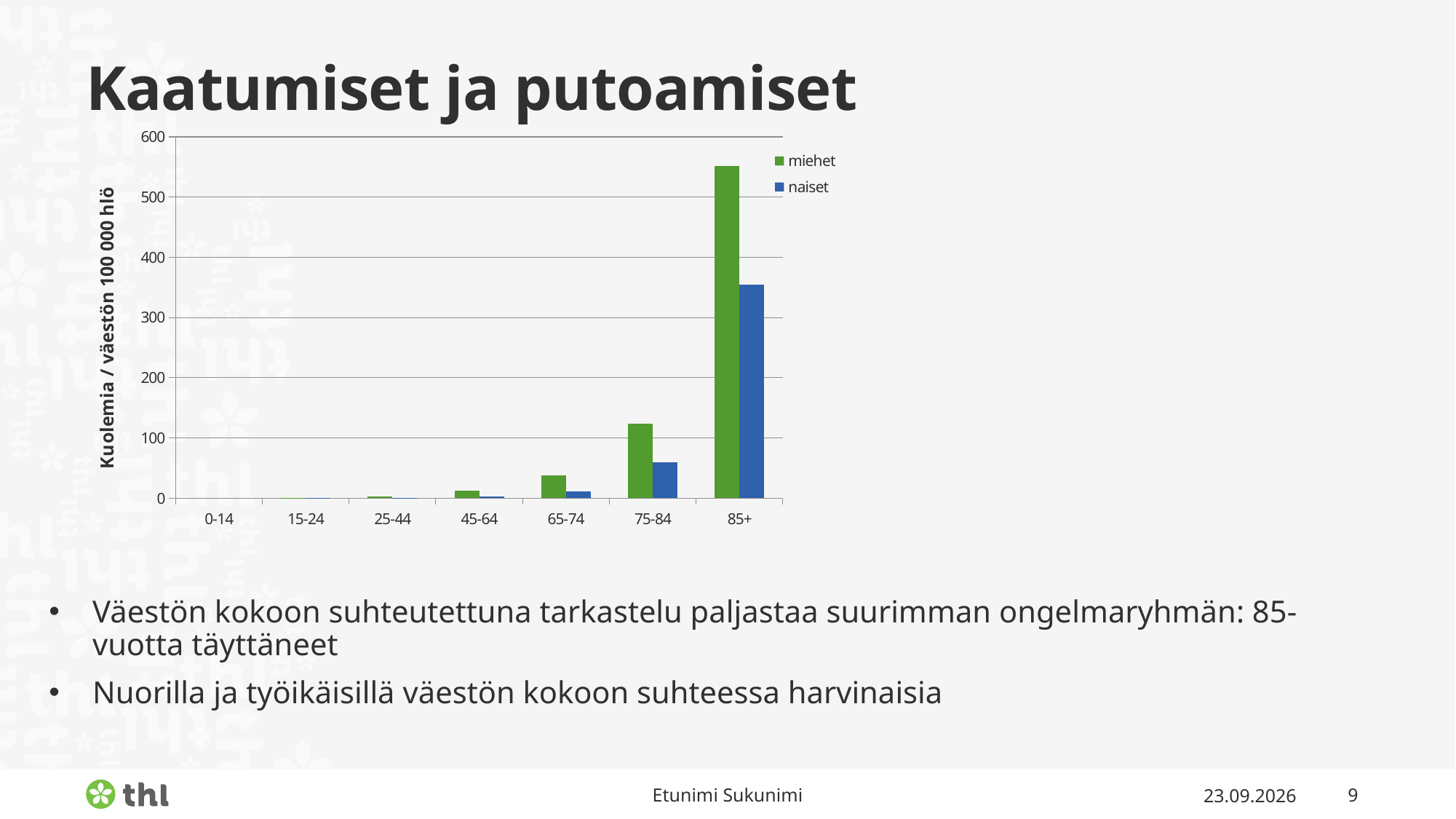
Is the value for miehet in the 75-84 age group greater or less than 100? greater Is the value for naiset in the 85+ age group greater or less than 400? less Which age group has the highest value for naiset? 85+ In the 85+ age group, which series has the larger value, miehet or naiset? miehet Is the value for miehet in the 85+ age group greater or less than 500? greater Do the values for miehet rise or fall as the age groups move from 0-14 to 85+? rise What kind of chart is shown on the slide? bar chart How many series does the chart legend list? 2 What is the label of the y axis of the chart? Kuolemia / väestön 100 000 hlö How many age groups are shown on the x axis of the chart? 7 Which age group has the highest value for miehet? 85+